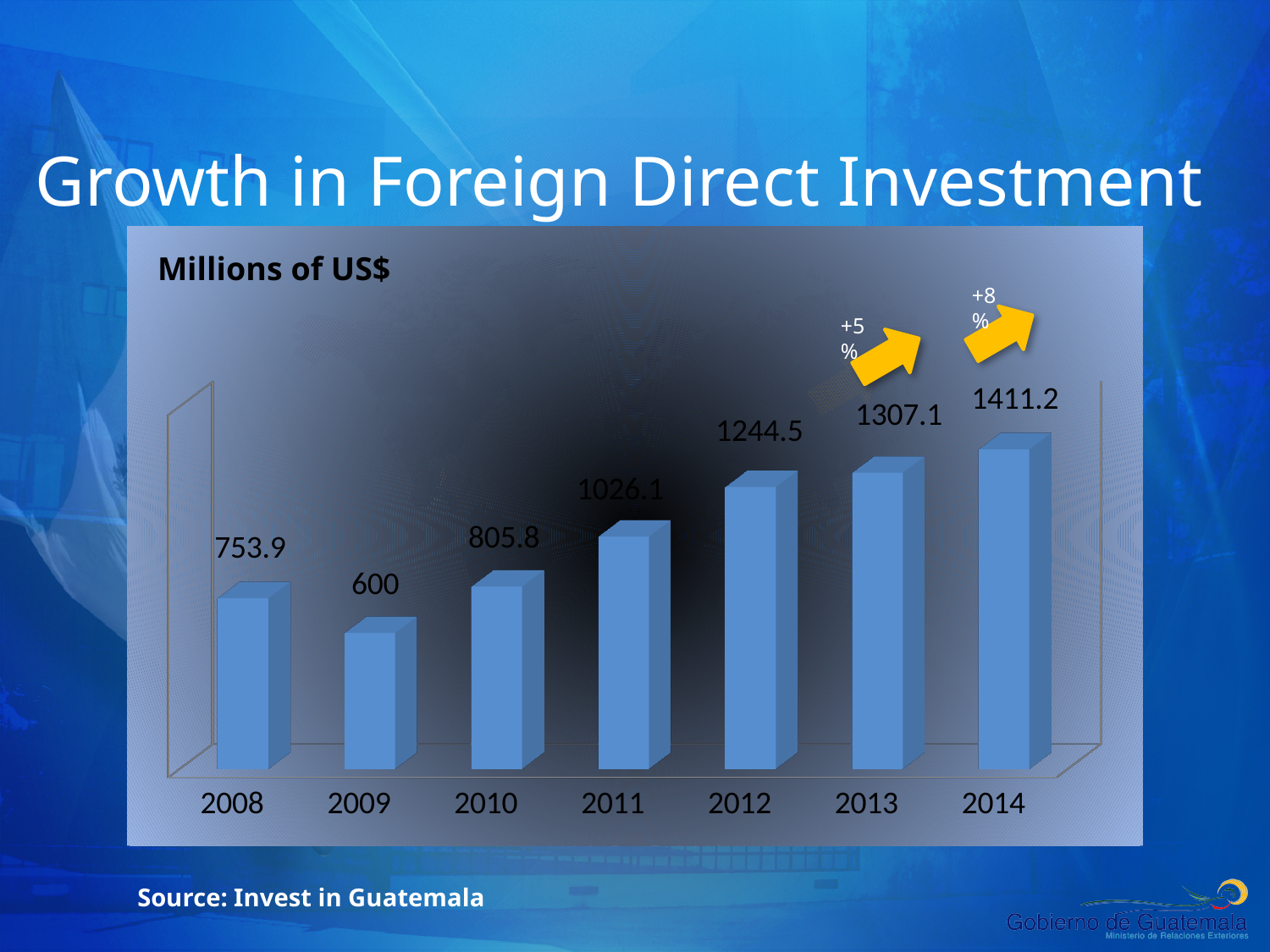
What is the value for 2014? 1411.2 What is the value for 2011? 1026.1 What unit is stated above the chart? Millions of US$ What is the value for 2008? 753.9 What kind of chart is this? bar chart What is the difference between the values for 2014 and 2013? 104.1 Do the values rise or fall from 2009 to 2014? rise Which year has the highest value? 2014 Which is larger, the value for 2008 or the value for 2010? 2010 Which year has the lowest value? 2009 How many years are shown on the chart? 7 What is the difference between the values for 2010 and 2009? 205.8